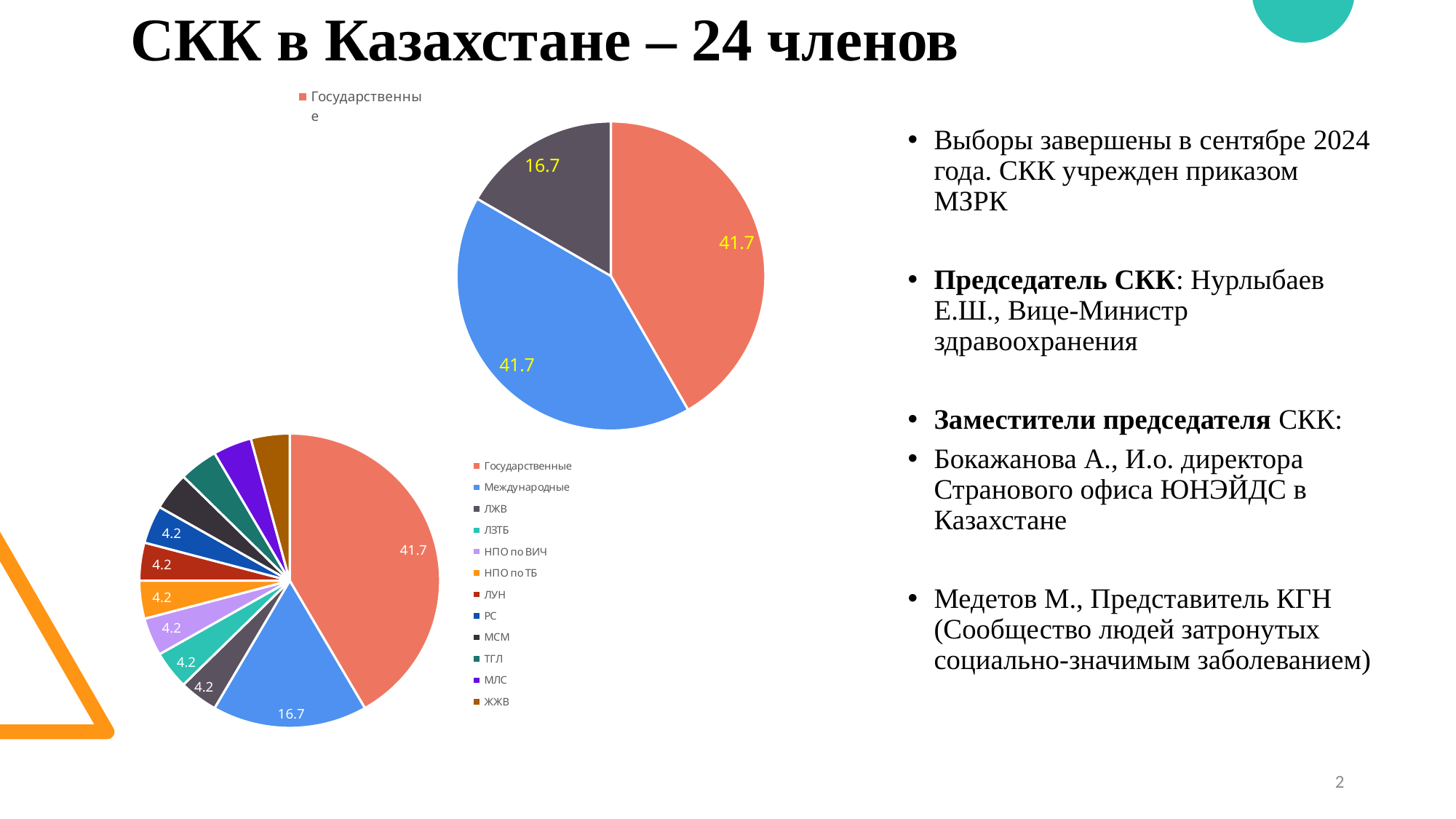
In the bottom pie chart, which category has the largest slice? Государственные What kind of chart is the top chart on the slide? pie chart In the bottom pie chart, what is the difference between the values for Государственные and Международные? 25.0 In the bottom pie chart, what is the value shown for Государственные? 41.7 In the bottom pie chart, what is the value shown for Международные? 16.7 In the top pie chart, what is the value of the smallest slice? 16.7 In the top pie chart, what is the value of the Государственные slice? 41.7 In the bottom pie chart, what is the value shown for НПО по ТБ? 4.2 In the bottom pie chart, which is larger: Международные or ЛЖВ? Международные In the bottom pie chart, what is the value shown for ЛЖВ? 4.2 How many categories does the legend of the bottom pie chart list? 12 How many slices does the top pie chart have? 3